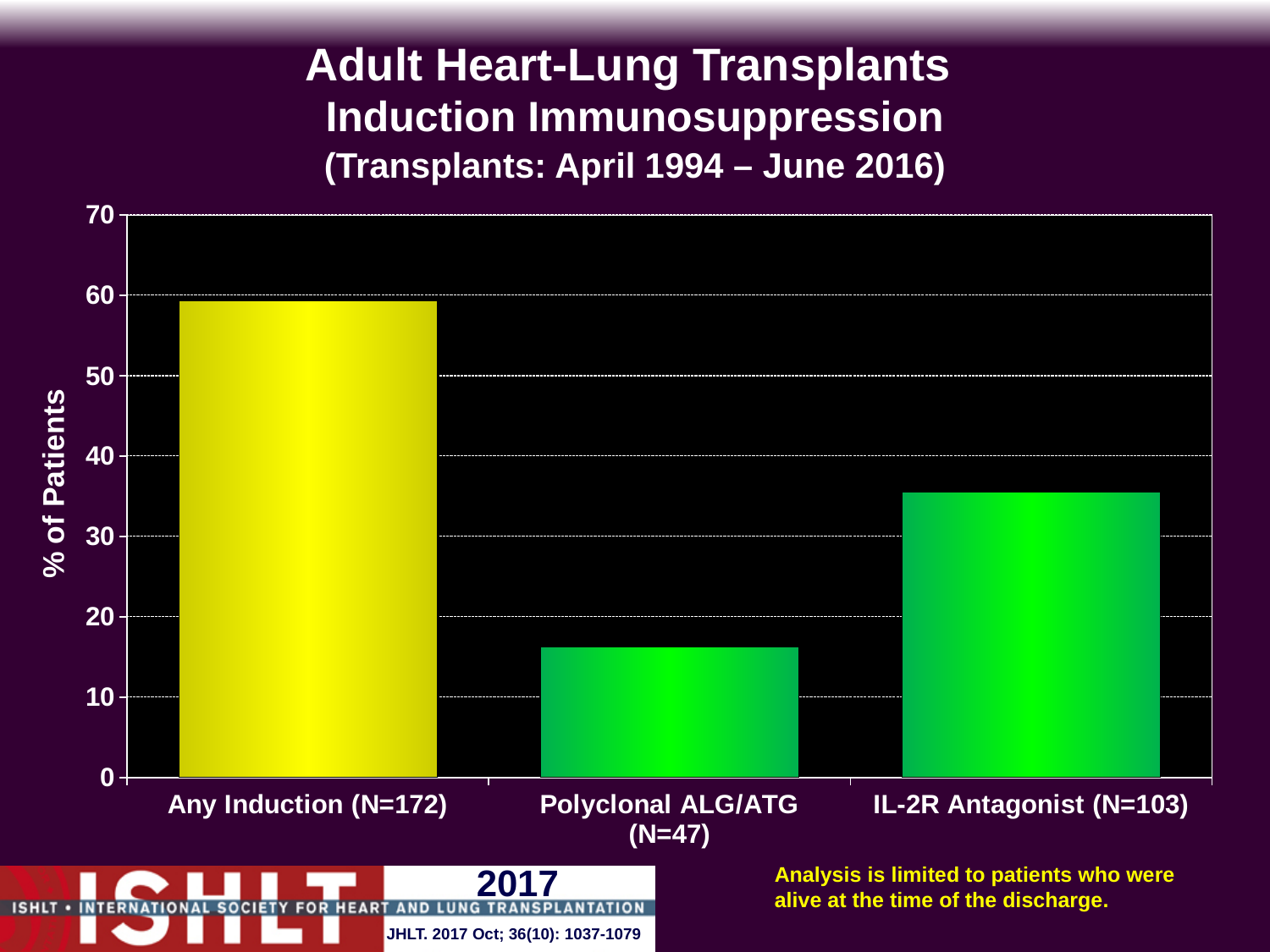
How many categories are plotted on the x axis? 3 Which category has the highest % of patients? Any Induction (N=172) Which category has the lowest % of patients? Polyclonal ALG/ATG (N=47) Is the value for Polyclonal ALG/ATG (N=47) greater or less than 20? less Is the value for IL-2R Antagonist (N=103) greater or less than 30? greater Is the value for Polyclonal ALG/ATG (N=47) greater or less than 10? greater Which is larger, the value for IL-2R Antagonist (N=103) or the value for Polyclonal ALG/ATG (N=47)? IL-2R Antagonist (N=103) What kind of chart is shown on the slide? bar chart What is the label of the y axis? % of Patients